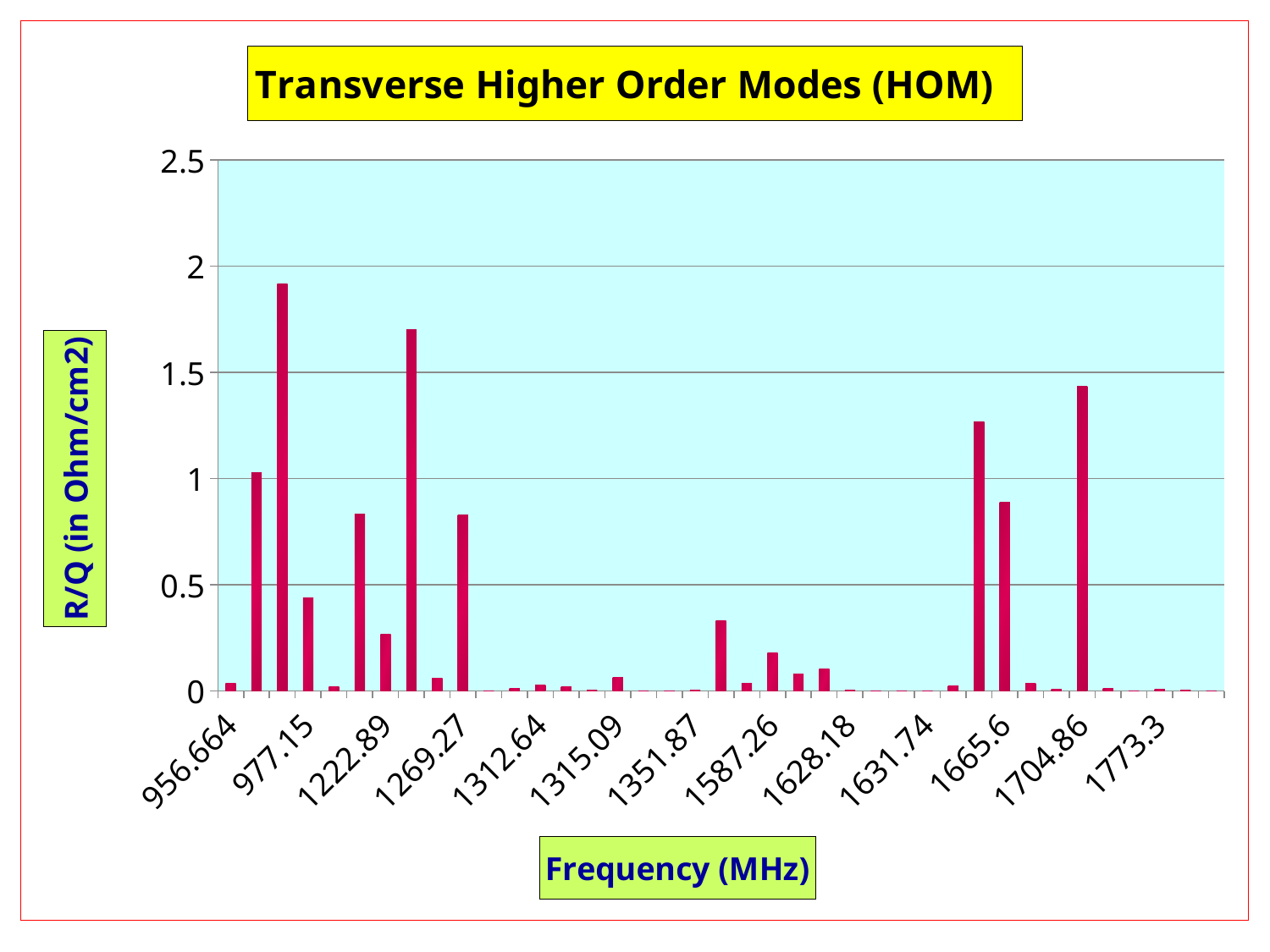
Is the value for 956.664 greater or less than 0.5? less What is the title of the chart? Transverse Higher Order Modes (HOM) What is the label of the vertical axis? R/Q (in Ohm/cm2) Is the value for 1269.27 greater or less than 1? less Is the value for 1665.6 greater or less than 0.5? greater Which has the larger value, 977.15 or 1269.27? 1269.27 What kind of chart is shown on the slide? bar chart Which has the larger value, 956.664 or 1665.6? 1665.6 How many frequency labels are printed along the x axis? 13